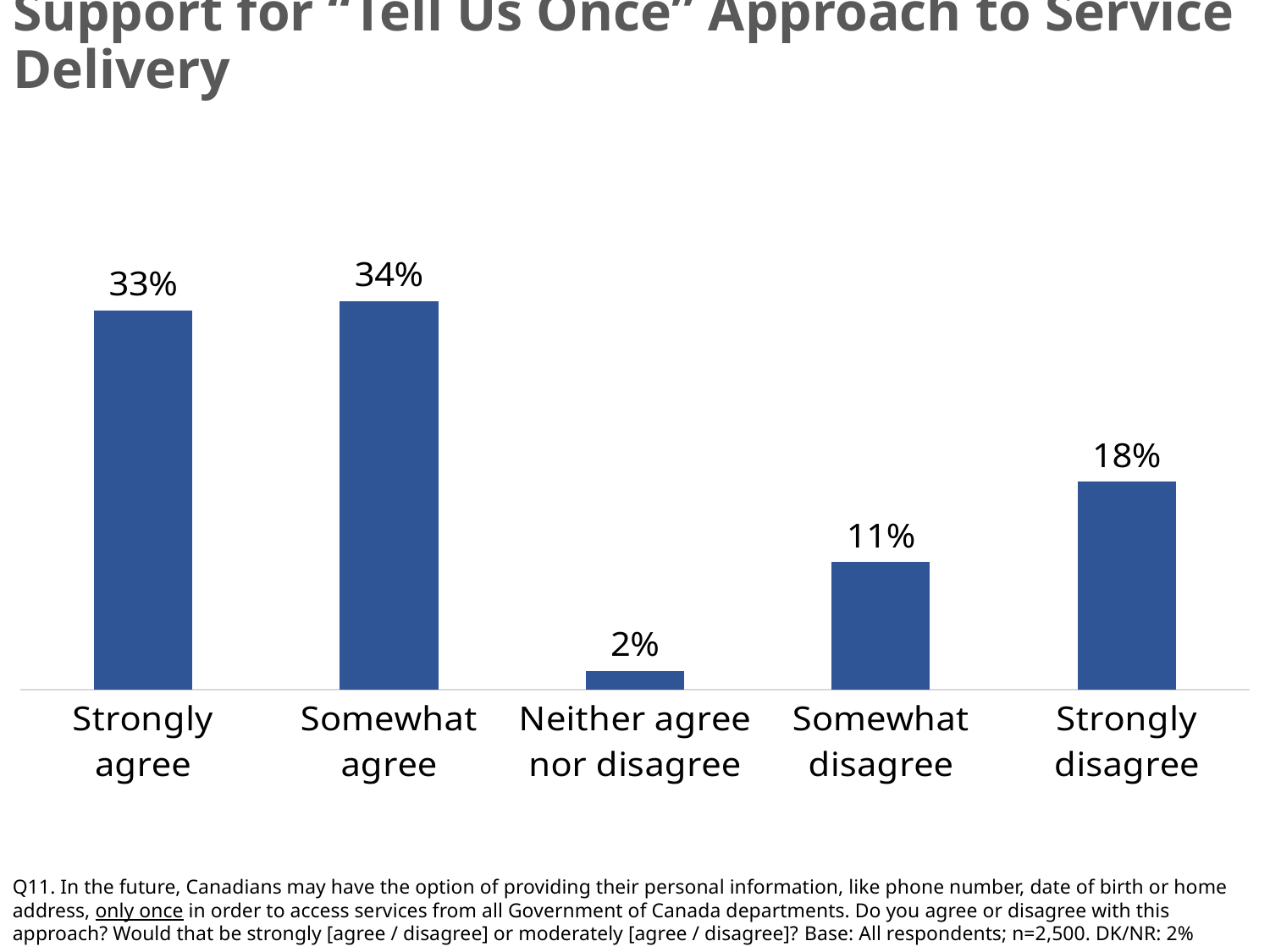
What is the value shown for "Somewhat agree"? 34% How many categories are shown on the chart? 5 Which category has the highest value? Somewhat agree Which category has the lowest value? Neither agree nor disagree What is the combined value of "Strongly agree" and "Somewhat agree"? 67% What is the difference between the "Strongly disagree" and "Somewhat disagree" values? 7% Which is larger: the value for "Strongly agree" or the value for "Strongly disagree"? Strongly agree What is the value shown for "Strongly disagree"? 18% What is the sample size (n) stated in the note below the chart? 2,500 What percentage of respondents strongly agree with the "Tell Us Once" approach? 33% What kind of chart is shown on the slide? Bar chart What percentage of respondents neither agree nor disagree? 2%